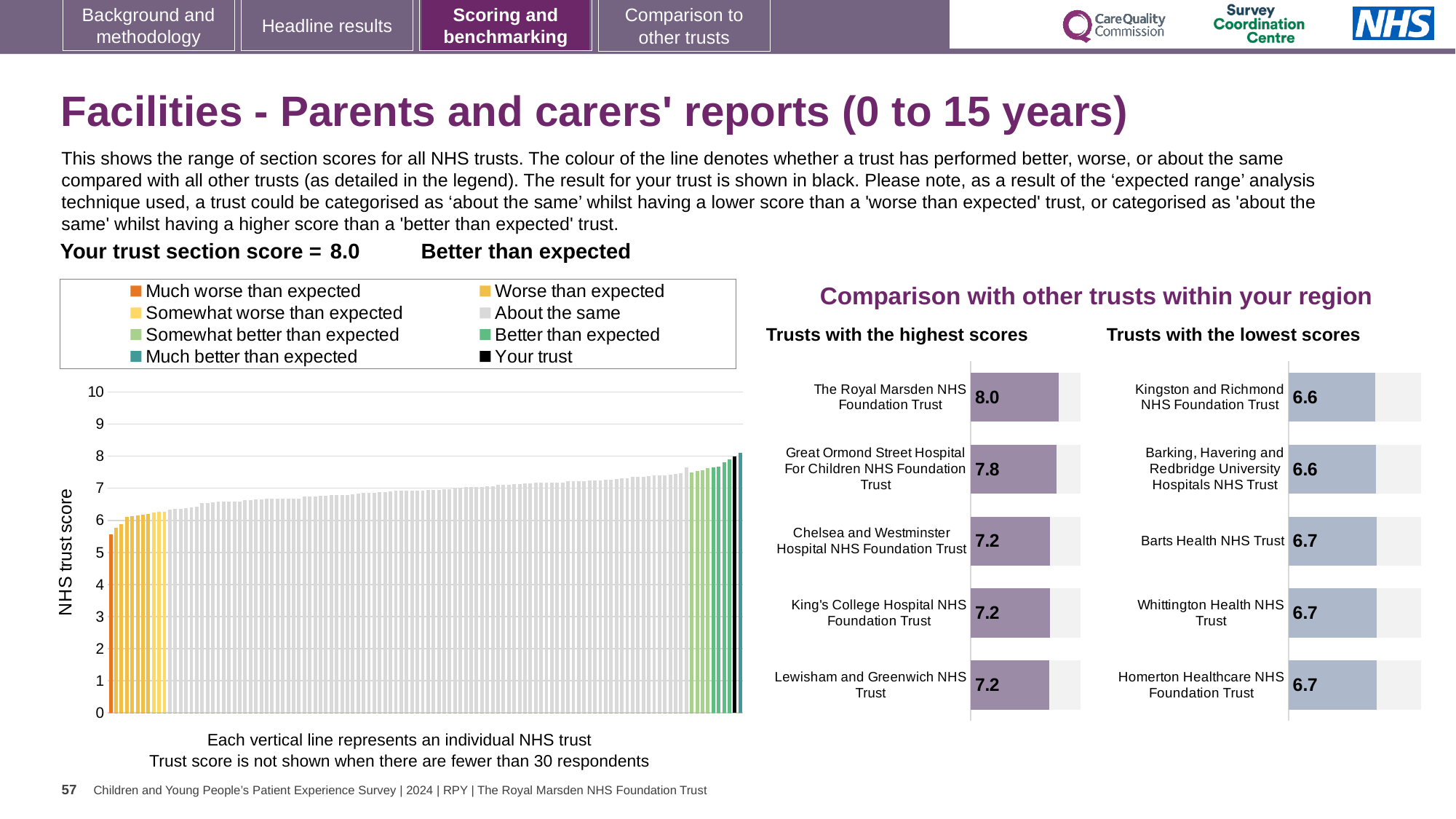
In the large chart on the left, do the trust scores rise or fall from left to right along the x axis? Rise In the 'Trusts with the highest scores' chart, which trust has the highest score? The Royal Marsden NHS Foundation Trust In the 'Trusts with the lowest scores' chart, what is the score for Kingston and Richmond NHS Foundation Trust? 6.6 In the 'Trusts with the lowest scores' chart, what is the difference between the scores of Homerton Healthcare NHS Foundation Trust and Kingston and Richmond NHS Foundation Trust? 0.1 In the 'Trusts with the highest scores' chart, what is the difference between the scores of The Royal Marsden NHS Foundation Trust and Great Ormond Street Hospital For Children NHS Foundation Trust? 0.2 In the 'Trusts with the highest scores' chart, what is the score for The Royal Marsden NHS Foundation Trust? 8.0 In the 'Trusts with the highest scores' chart, what is the score for Great Ormond Street Hospital For Children NHS Foundation Trust? 7.8 In the 'Trusts with the highest scores' chart, how many trusts are shown? 5 In the 'Trusts with the lowest scores' chart, what is the score for Barts Health NHS Trust? 6.7 In the 'Trusts with the lowest scores' chart, which is larger: the score for Whittington Health NHS Trust or the score for Barking, Havering and Redbridge University Hospitals NHS Trust? Whittington Health NHS Trust What kind of chart is the large chart on the left showing NHS trust scores? Bar chart How many entries does the legend of the large chart on the left list? 8